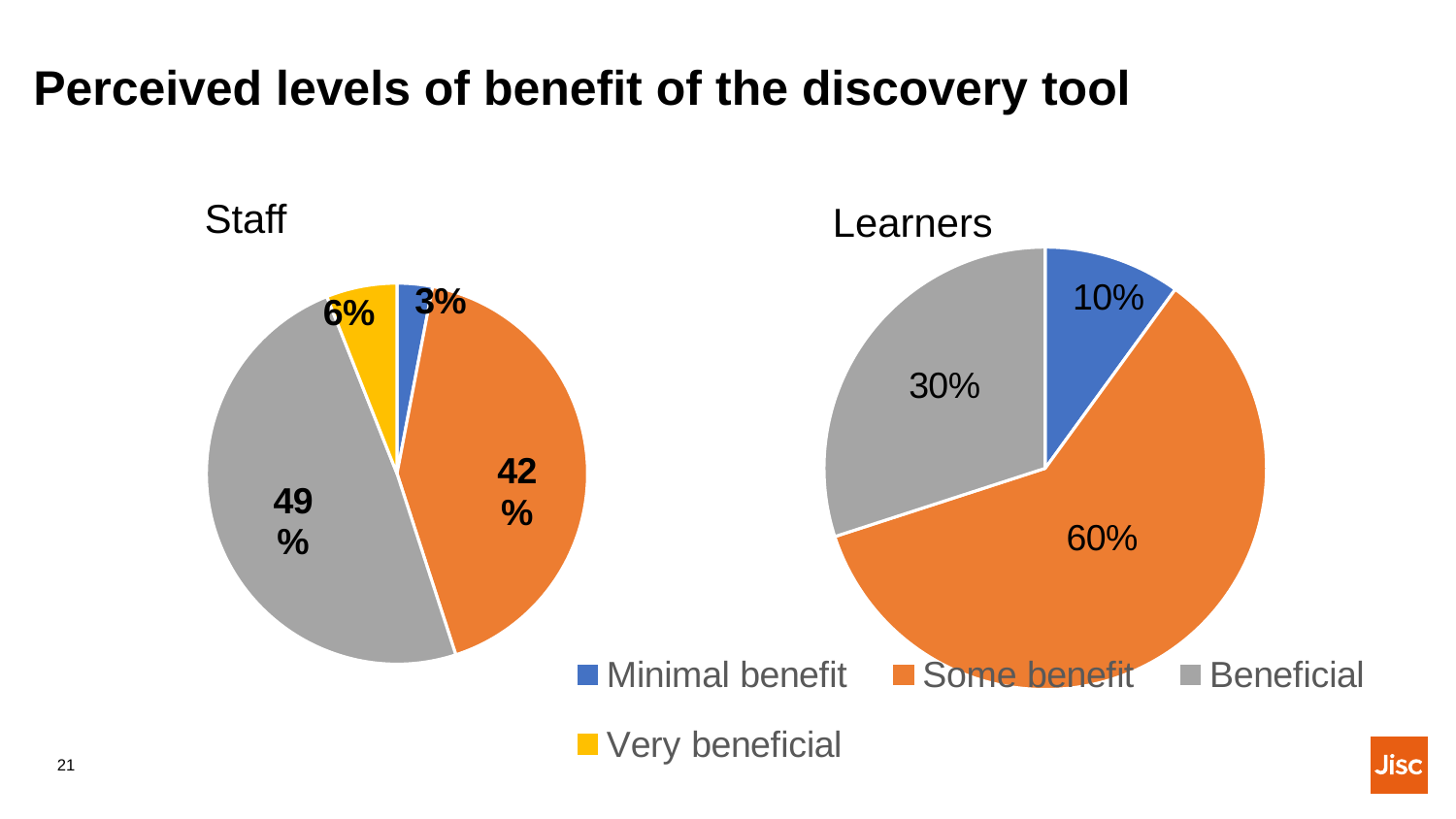
How many categories does the legend list? 4 In the Staff pie chart, what percentage of staff rated the discovery tool as 'Beneficial'? 49% In the Staff pie chart, which category has the smallest share? Minimal benefit Which group has a larger 'Beneficial' share, Staff or Learners? Staff How many slices does the Learners pie chart have? 3 In the Learners pie chart, which category has the smallest share? Minimal benefit In the Learners pie chart, what percentage of learners reported 'Minimal benefit'? 10% In the Staff pie chart, what percentage corresponds to 'Very beneficial'? 6% In the Learners pie chart, what share of learners said the tool had 'Some benefit'? 60% In the Staff pie chart, which category has the largest share? Beneficial What is the difference between the 'Some benefit' share for Learners and the 'Some benefit' share for Staff? 18% What type of charts are shown on the slide? Pie charts